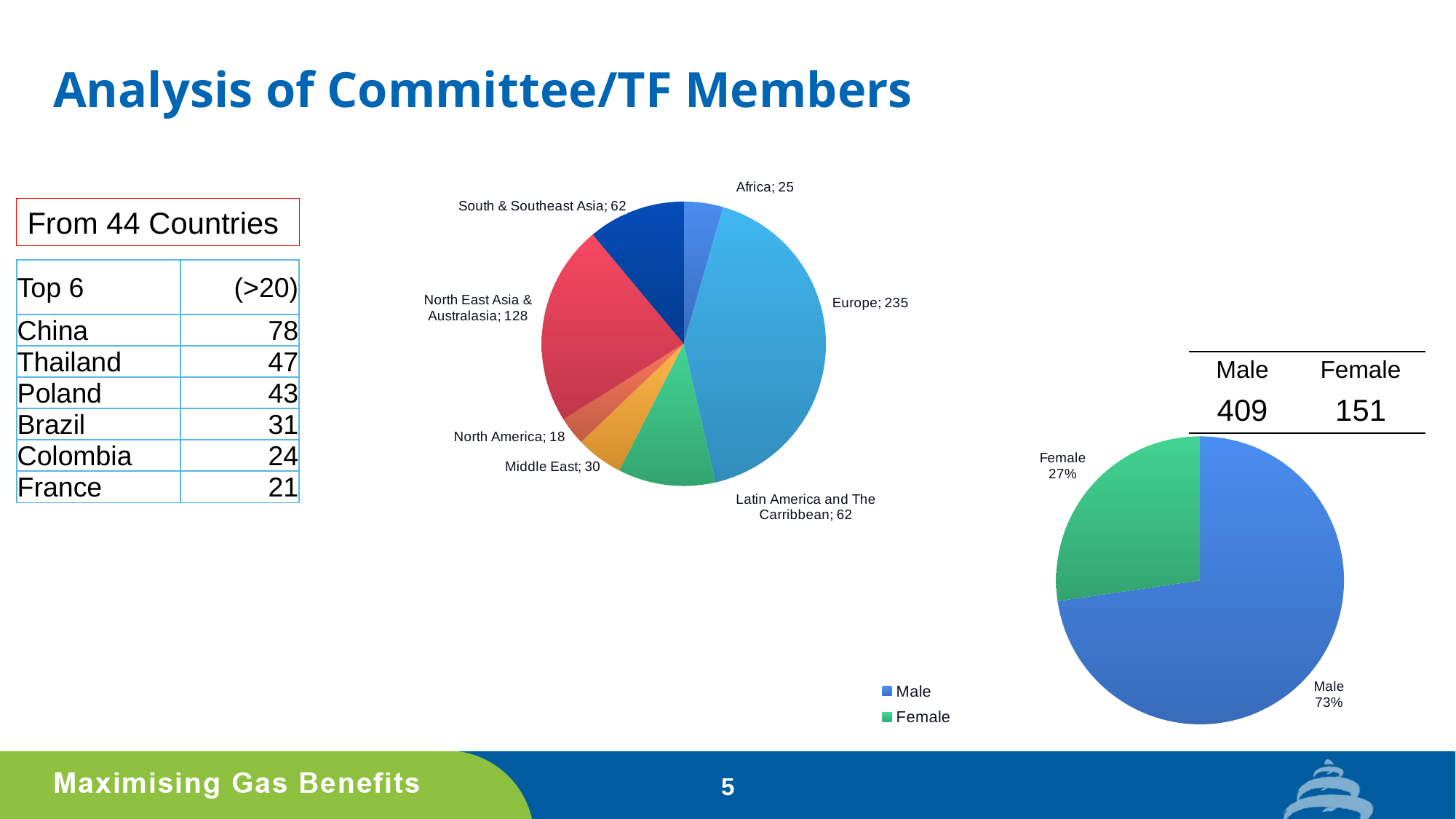
In the centre pie chart, which region has the largest slice? Europe In the right-hand pie chart, what share of the pie is Male? 73% In the centre pie chart, what is the value for Europe? 235 In the right-hand pie chart, what share of the pie is Female? 27% In the centre pie chart, which region has the smallest slice? North America In the centre pie chart, what is the difference between the values for Europe and North East Asia & Australasia? 107 What type of chart is the chart on the right of the slide? Pie chart How many slices does the centre pie chart have? 7 In the centre pie chart, what is the value for Middle East? 30 In the centre pie chart, what is the value for North East Asia & Australasia? 128 In the centre pie chart, which is larger, Africa or Middle East? Middle East How many entries does the legend of the right-hand pie chart list? 2